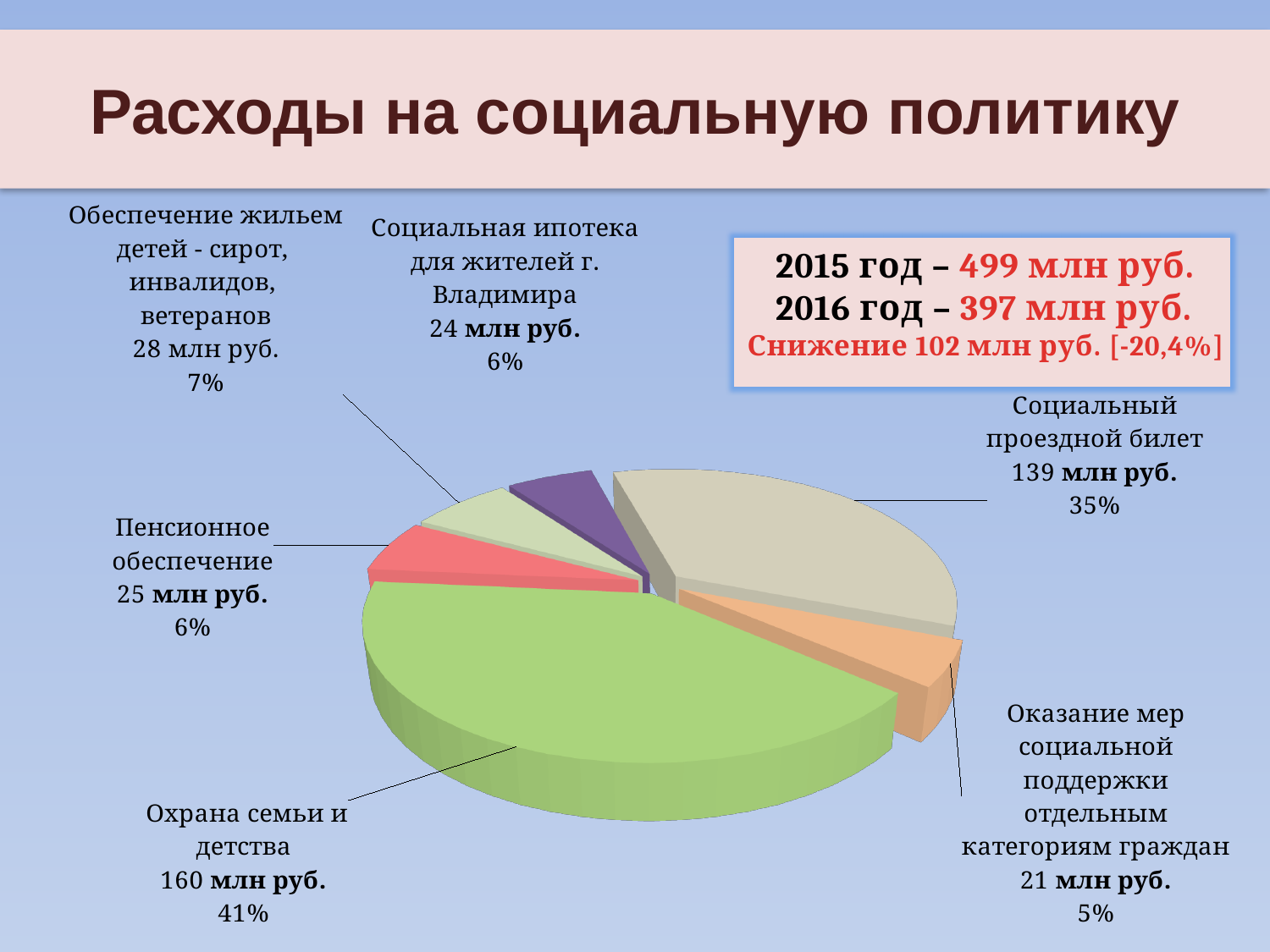
Which is larger: «Обеспечение жильем детей-сирот, инвалидов, ветеранов» or «Социальная ипотека для жителей г. Владимира»? Обеспечение жильем детей-сирот, инвалидов, ветеранов What is the difference in млн руб. between «Охрана семьи и детства» and «Социальный проездной билет»? 21 млн руб. What share of the pie does «Социальный проездной билет» represent? 35% Which category has the largest slice of the pie? Охрана семьи и детства Which category has the smallest slice of the pie? Оказание мер социальной поддержки отдельным категориям граждан According to the text box on the slide, what was the total spending in 2016? 397 млн руб. What is the title of the slide containing the chart? Расходы на социальную политику How many slices does the pie chart have? 6 What is the value for «Охрана семьи и детства»? 160 млн руб. What is the value for «Пенсионное обеспечение»? 25 млн руб. What percentage is shown for «Оказание мер социальной поддержки отдельным категориям граждан»? 5% What type of chart is shown on the slide? Pie chart